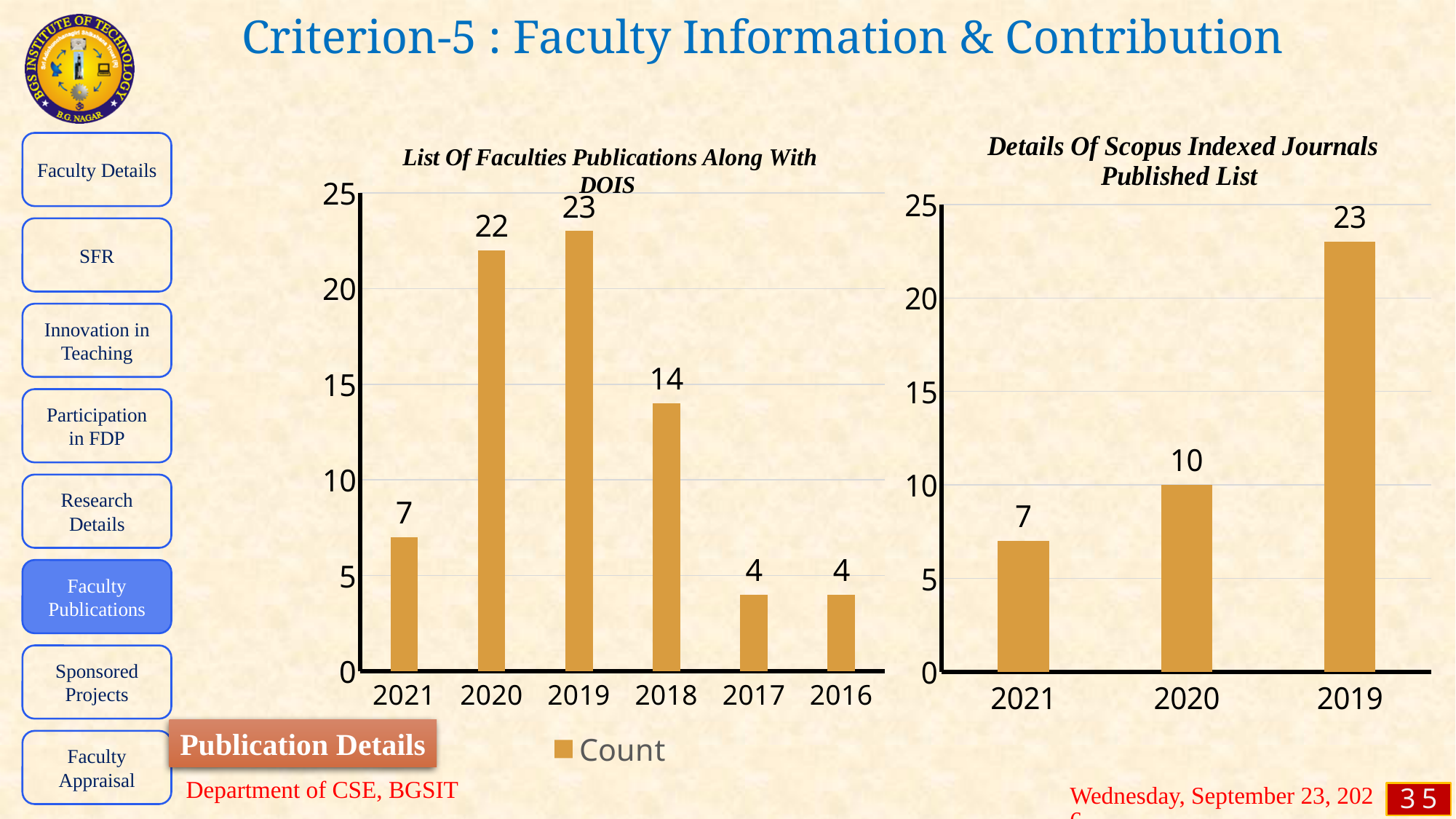
In the 'List Of Faculties Publications Along With DOIS' chart, which is larger, the value for 2020 or the value for 2018? 2020 In the 'List Of Faculties Publications Along With DOIS' chart, what is the value for 2018? 14 In the 'List Of Faculties Publications Along With DOIS' chart, what is the difference between the values for 2019 and 2021? 16 In the 'List Of Faculties Publications Along With DOIS' chart, which year has the highest value? 2019 What kind of chart is the 'Details Of Scopus Indexed Journals Published List' chart? Bar chart In the 'Details Of Scopus Indexed Journals Published List' chart, which year has the lowest value? 2021 In the 'List Of Faculties Publications Along With DOIS' chart, what series name does the legend show? Count In the 'List Of Faculties Publications Along With DOIS' chart, what is the value for 2020? 22 In the 'Details Of Scopus Indexed Journals Published List' chart, what is the difference between the values for 2019 and 2020? 13 In the 'Details Of Scopus Indexed Journals Published List' chart, what is the value for 2020? 10 In the 'Details Of Scopus Indexed Journals Published List' chart, how many years are shown on the x axis? 3 In the 'List Of Faculties Publications Along With DOIS' chart, how many years are shown on the x axis? 6